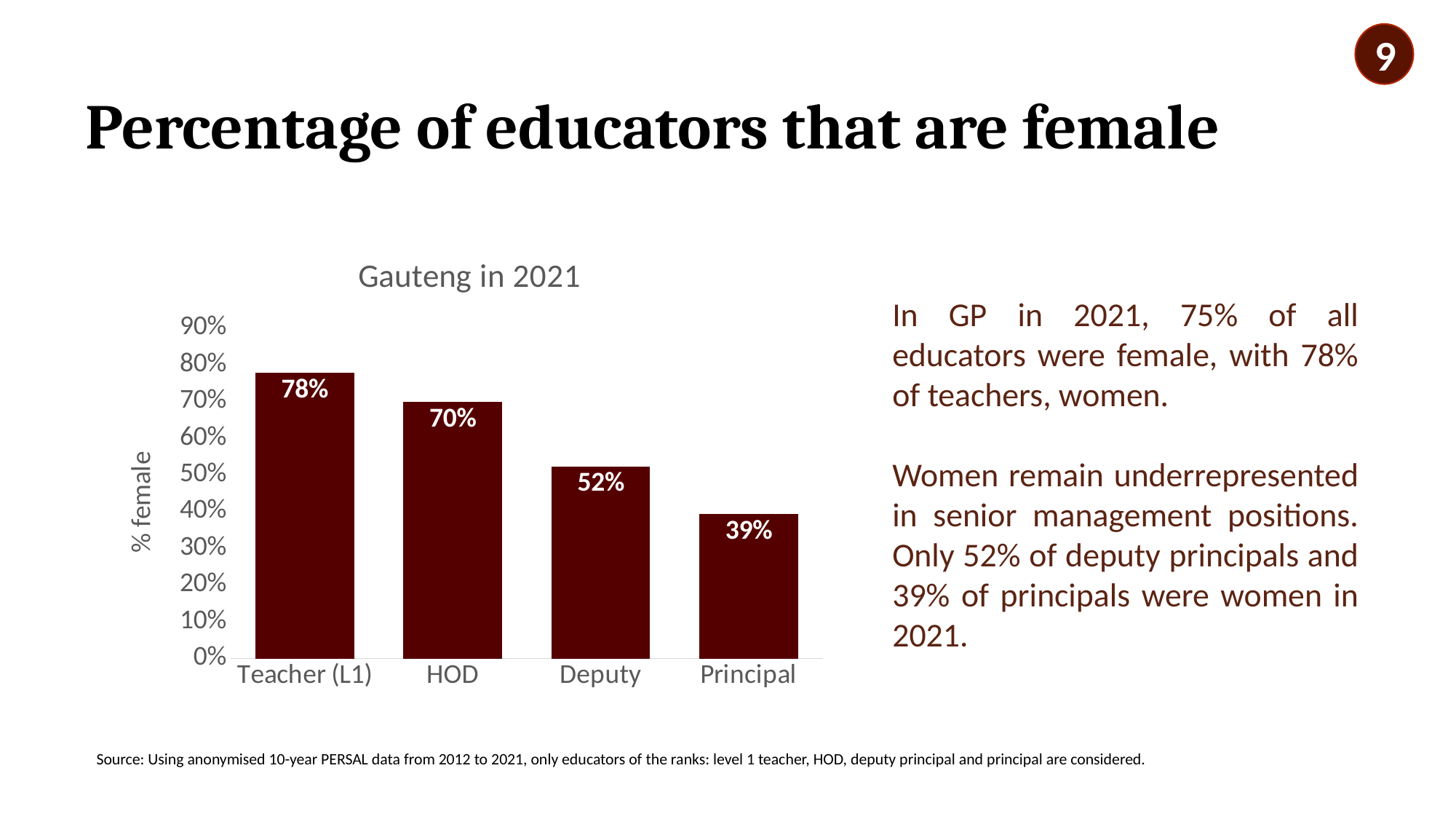
How many categories are shown on the x axis? 4 What percentage of Deputy educators are female? 52% Which category has the highest percentage of female educators? Teacher (L1) What percentage of Teacher (L1) educators are female? 78% What is the value shown for Principal? 39% What is the difference between the Teacher (L1) value and the Principal value? 39% Which is larger, the value for HOD or the value for Deputy? HOD What kind of chart is shown on the slide? Bar chart Which category has the lowest percentage of female educators? Principal What is the value shown for HOD? 70% What is the difference between the HOD value and the Deputy value? 18% Do the values rise or fall from Teacher (L1) to Principal along the x axis? Fall